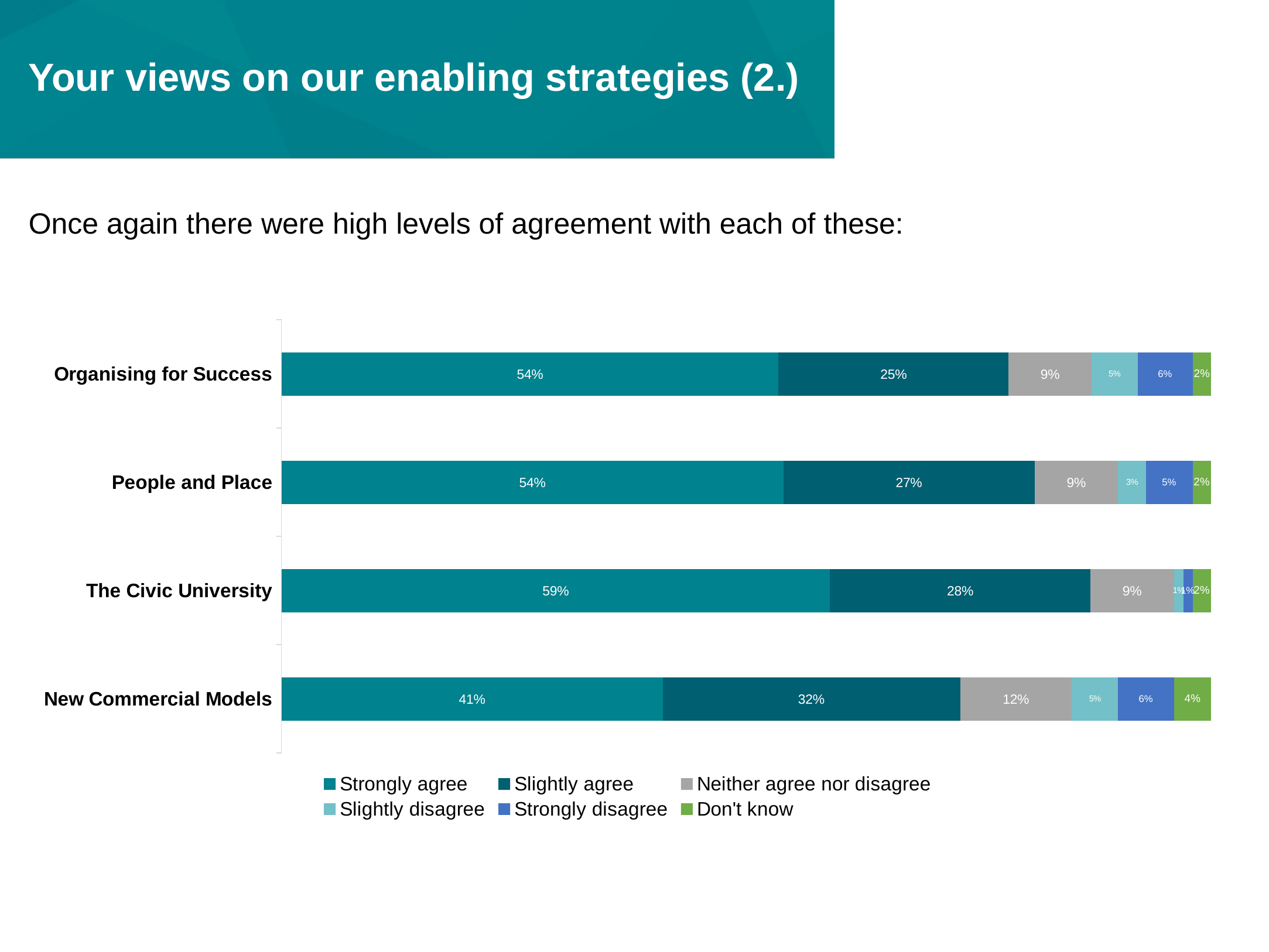
What is the Slightly agree value for New Commercial Models? 32% What is the difference between the Strongly agree values for The Civic University and New Commercial Models? 18% How many categories are shown on the chart? 4 What is the Neither agree nor disagree value for People and Place? 9% Which category has the highest Strongly agree value? The Civic University Which category has the lowest Strongly agree value? New Commercial Models How many series does the legend list? 6 What kind of chart is shown on the slide? Stacked bar chart Which legend entry is shown in green? Don't know What percentage of respondents strongly agree with The Civic University? 59% Which is larger, the Slightly agree value for People and Place or for Organising for Success? People and Place What is the Don't know value for New Commercial Models? 4%